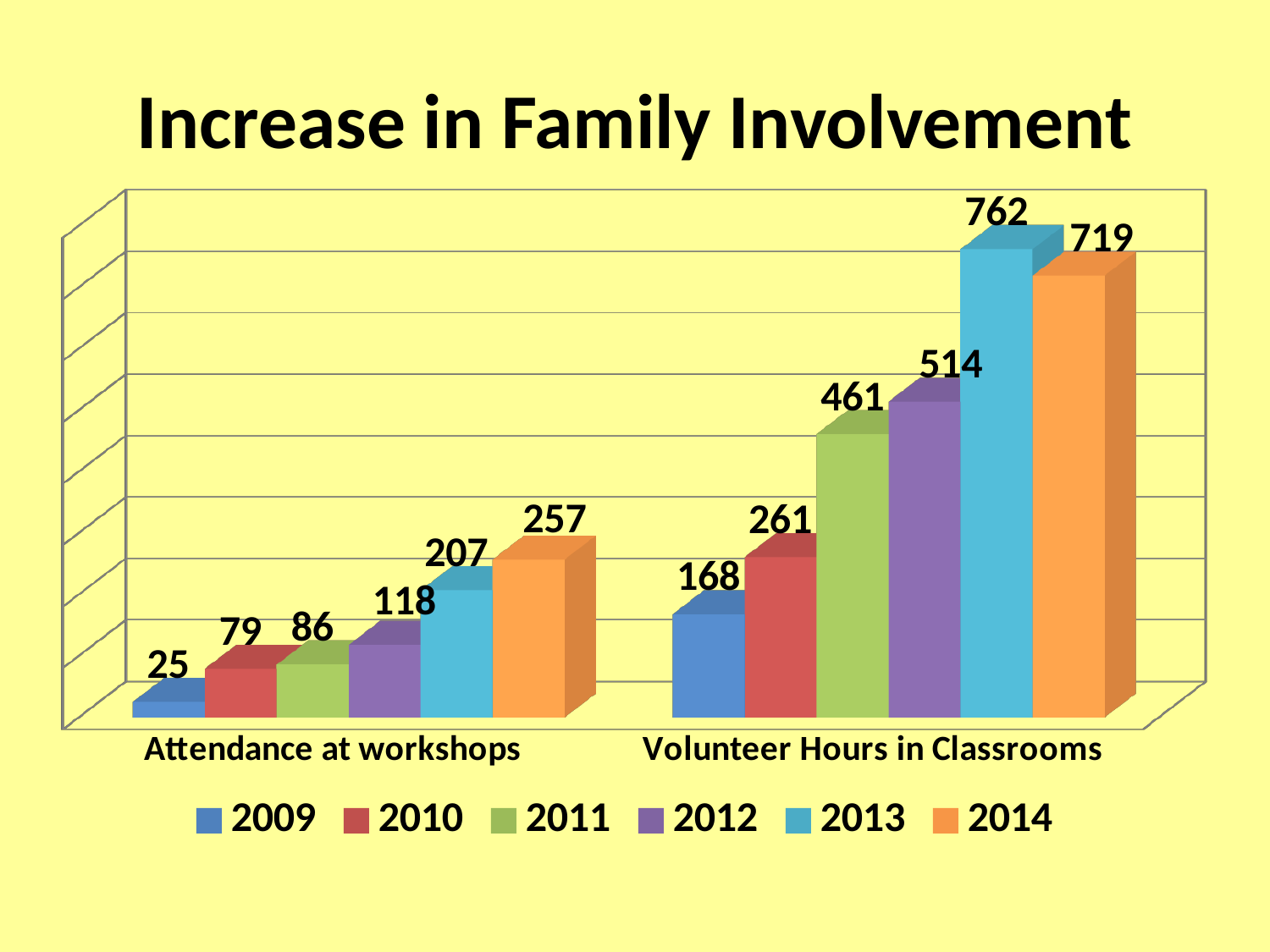
What is the difference between the 2013 and 2014 values for Volunteer Hours in Classrooms? 43 What is the value for 2012 in the Attendance at workshops category? 118 How many categories are shown on the x axis? 2 What kind of chart is shown on the slide? Bar chart What is the value for 2009 in the Attendance at workshops category? 25 What is the value for 2013 in the Volunteer Hours in Classrooms category? 762 What is the difference between the 2014 and 2013 values for Attendance at workshops? 50 Which year has the highest value for Volunteer Hours in Classrooms? 2013 What is the title of the chart? Increase in Family Involvement Which year has the lowest value for Attendance at workshops? 2009 Which is larger: the 2011 value for Volunteer Hours in Classrooms or the 2012 value for Volunteer Hours in Classrooms? 2012 How many series does the legend list? 6